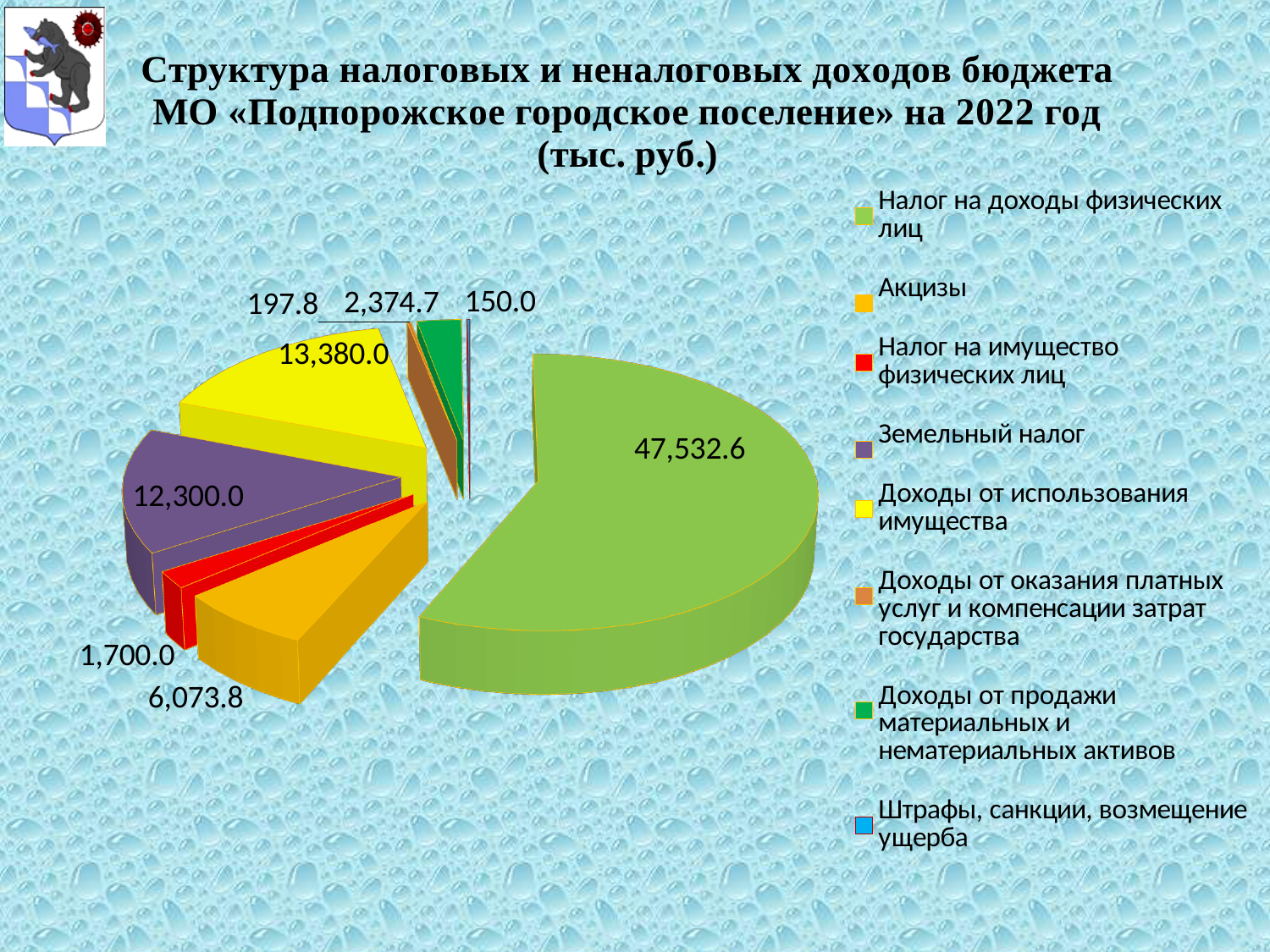
What is the difference between «Доходы от использования имущества» and «Земельный налог»? 1,080.0 What is the value for «Земельный налог»? 12,300.0 Which category has the smallest value? Штрафы, санкции, возмещение ущерба What is the value for «Штрафы, санкции, возмещение ущерба»? 150.0 What is the value for «Акцизы»? 6,073.8 Which is larger: «Акцизы» or «Налог на имущество физических лиц»? Акцизы How many categories does the legend list? 8 What type of chart is shown on the slide? Pie chart What is the value for «Доходы от использования имущества»? 13,380.0 What colour is the slice for «Земельный налог»? Purple What is the value for «Налог на доходы физических лиц»? 47,532.6 Which category has the largest value? Налог на доходы физических лиц